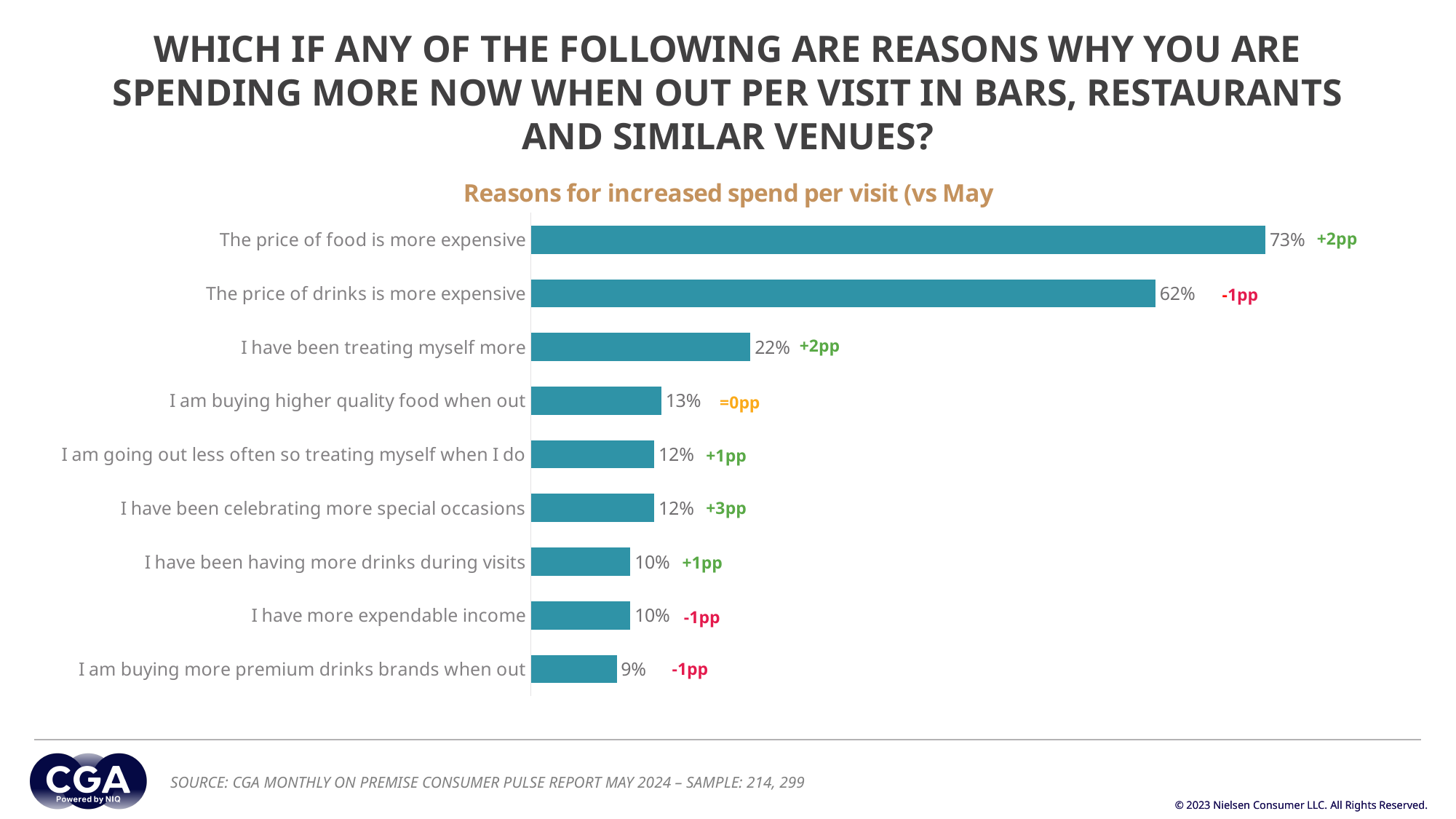
What percentage of respondents said they are buying more premium drinks brands when out? 9% Which reason has the lowest percentage? I am buying more premium drinks brands when out What percentage of respondents said the price of food is more expensive? 73% What is the difference in percentage points between 'The price of food is more expensive' and 'The price of drinks is more expensive'? 11 percentage points What is the title of the chart? Reasons for increased spend per visit (vs May What is the change versus May shown for 'I have been celebrating more special occasions'? +3pp How many reasons are listed in the chart? 9 What is the change versus May shown for 'I am buying higher quality food when out'? =0pp Which is larger: the percentage for 'I am buying higher quality food when out' or for 'I have been having more drinks during visits'? I am buying higher quality food when out Which reason has the highest percentage? The price of food is more expensive What percentage of respondents said they have been treating themselves more? 22% What kind of chart is shown on the slide? Bar chart